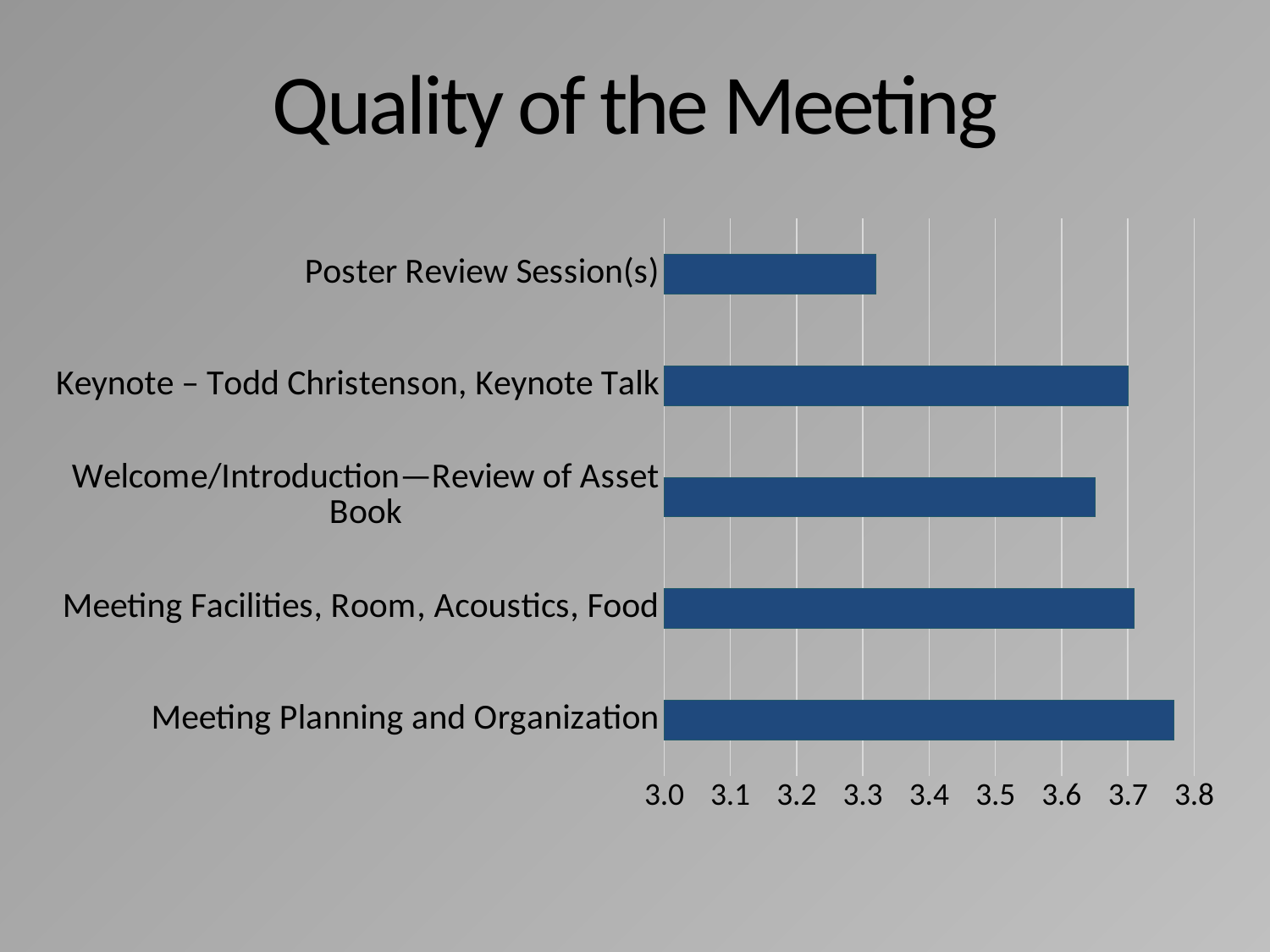
Is the value for Meeting Planning and Organization greater or less than 3.7? greater Is the value for Keynote – Todd Christenson, Keynote Talk greater or less than 3.6? greater How many categories are plotted in the chart? 5 What is the title of the chart? Quality of the Meeting Is the value for Welcome/Introduction—Review of Asset Book greater or less than 3.7? less Which category has the highest value? Meeting Planning and Organization Which is larger, the value for Meeting Planning and Organization or the value for Welcome/Introduction—Review of Asset Book? Meeting Planning and Organization Which category has the lowest value? Poster Review Session(s) Which is larger, the value for Poster Review Session(s) or the value for Meeting Facilities, Room, Acoustics, Food? Meeting Facilities, Room, Acoustics, Food What kind of chart is shown on the slide? bar chart